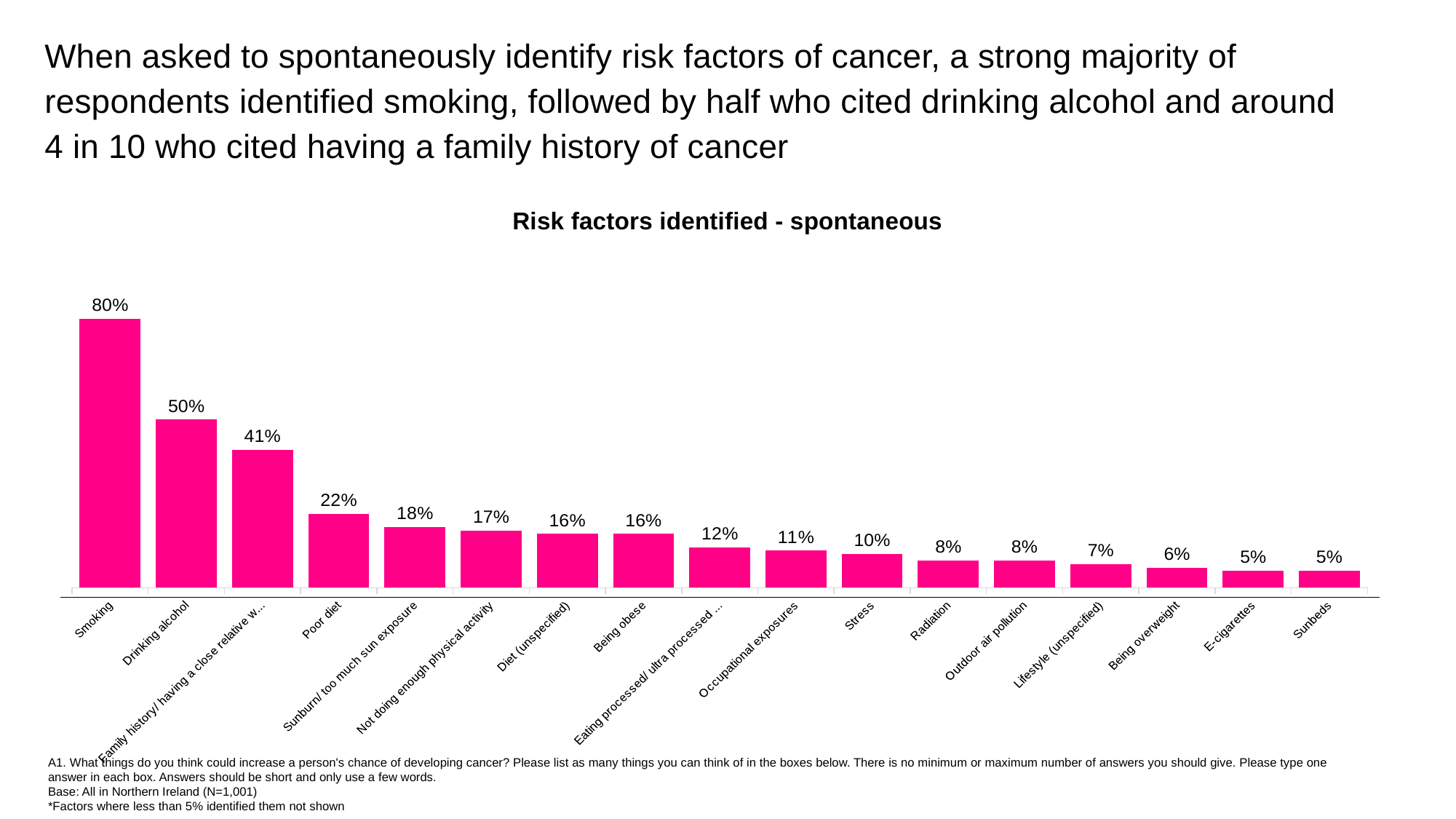
What is the value shown for Drinking alcohol? 50% What is the difference between the values for Smoking and Drinking alcohol? 30% What is the value for Being overweight? 6% Which risk factor has the highest percentage? Smoking What is the value for Stress? 10% What type of chart is shown on the slide? Bar chart Which is larger, the value for Radiation or the value for Stress? Stress What percentage is shown for Poor diet? 22% What percentage of respondents identified smoking as a risk factor? 80% How many risk factors are shown in the chart? 17 What is the title of the chart? Risk factors identified - spontaneous What is the difference between the values for Poor diet and Sunburn/ too much sun exposure? 4%